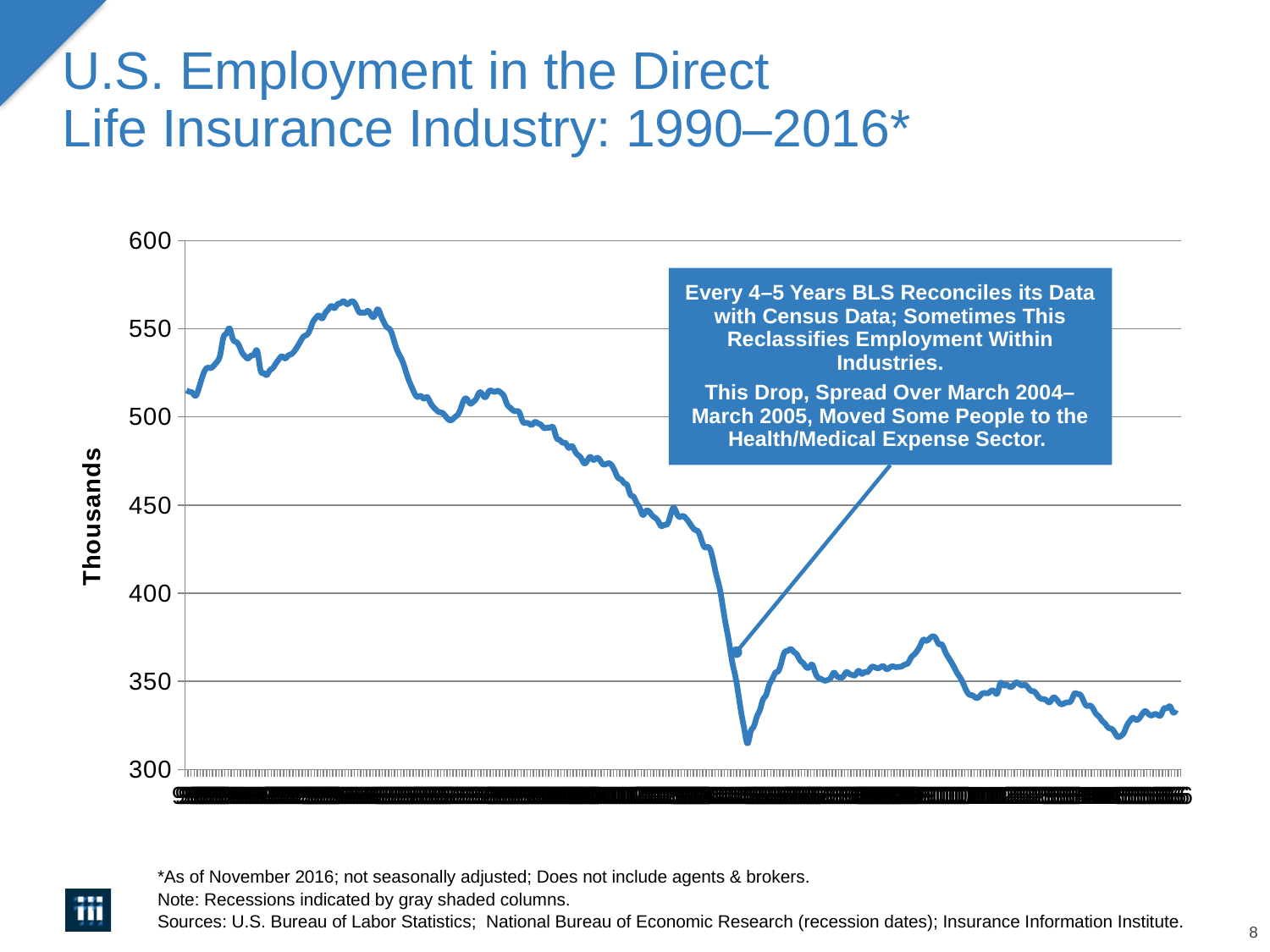
Is the value at the start of the line (left end) greater or less than 500? greater What is the label on the vertical axis of the chart? Thousands Which is larger: the value at the left end of the line or the value at the right end of the line? the left end According to the callout on the chart, over which period was the drop spread? March 2004–March 2005 Is the value at the point marked by the callout arrow greater or less than 400? less How many data series are plotted in the chart? 1 Is the highest value reached by the line greater or less than 550? greater What is the highest value shown on the vertical axis of the chart? 600 What kind of chart is shown on the slide? line chart Overall, do the values in the chart rise or fall from the left end to the right end of the x axis? fall